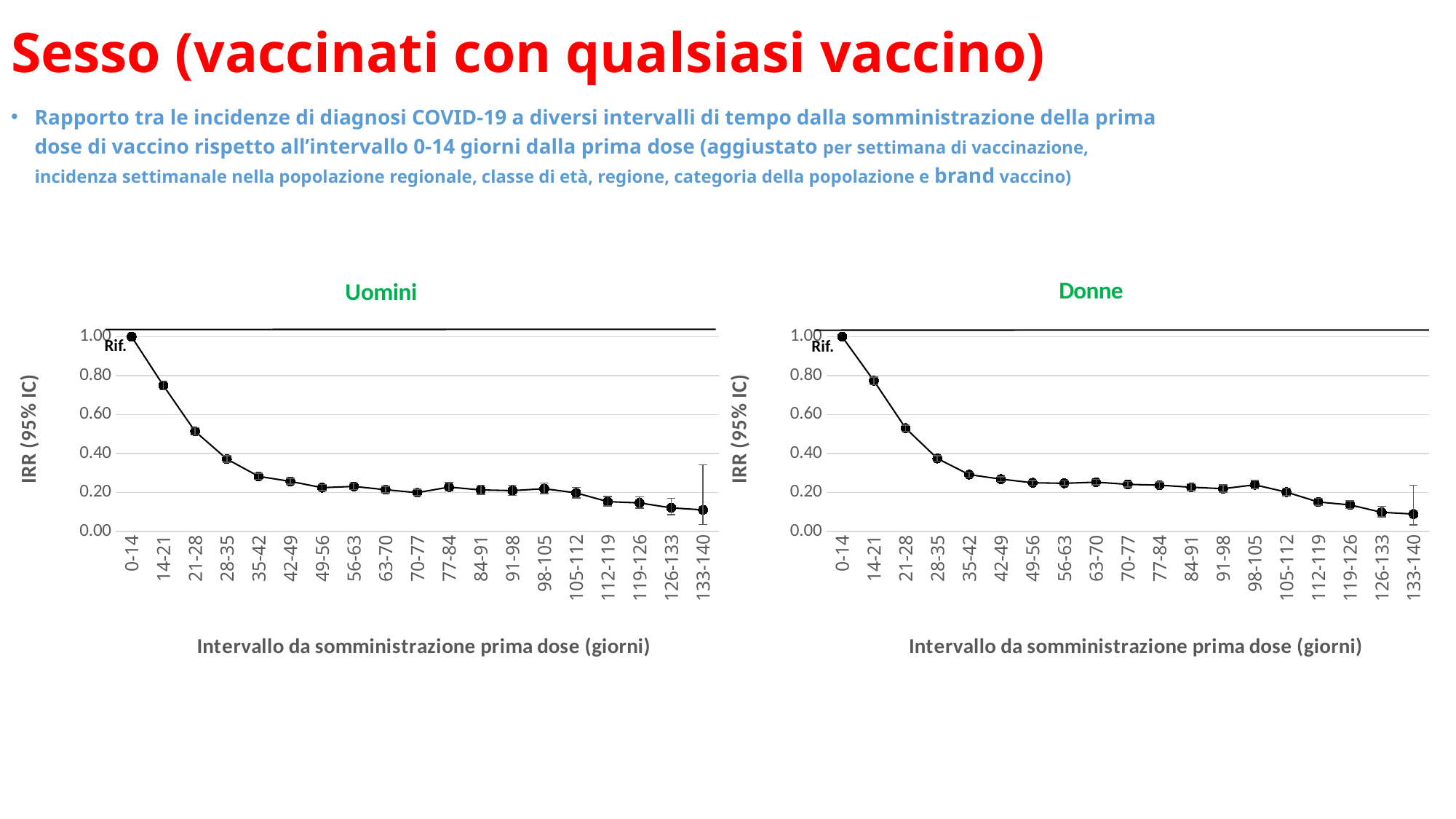
In the Donne chart, what is the IRR value for the 0-14 interval? 1.00 In the Donne chart, is the value for 126-133 greater or less than 0.20? less In the Donne chart, do the IRR values generally rise or fall as the interval from the first dose increases? fall In the Uomini chart, is the value for 28-35 greater or less than 0.40? less What label is attached to the first point (0-14) in the Donne chart? Rif. In the Uomini chart, which is larger, the value for 14-21 or the value for 21-28? 14-21 In the Uomini chart, which interval has the highest IRR value? 0-14 What kind of chart is the Uomini chart? line chart How many interval categories are shown on the x axis of the Donne chart? 19 What is the y-axis label of the Uomini chart? IRR (95% IC) In the Donne chart, is the value for 14-21 greater or less than 0.60? greater